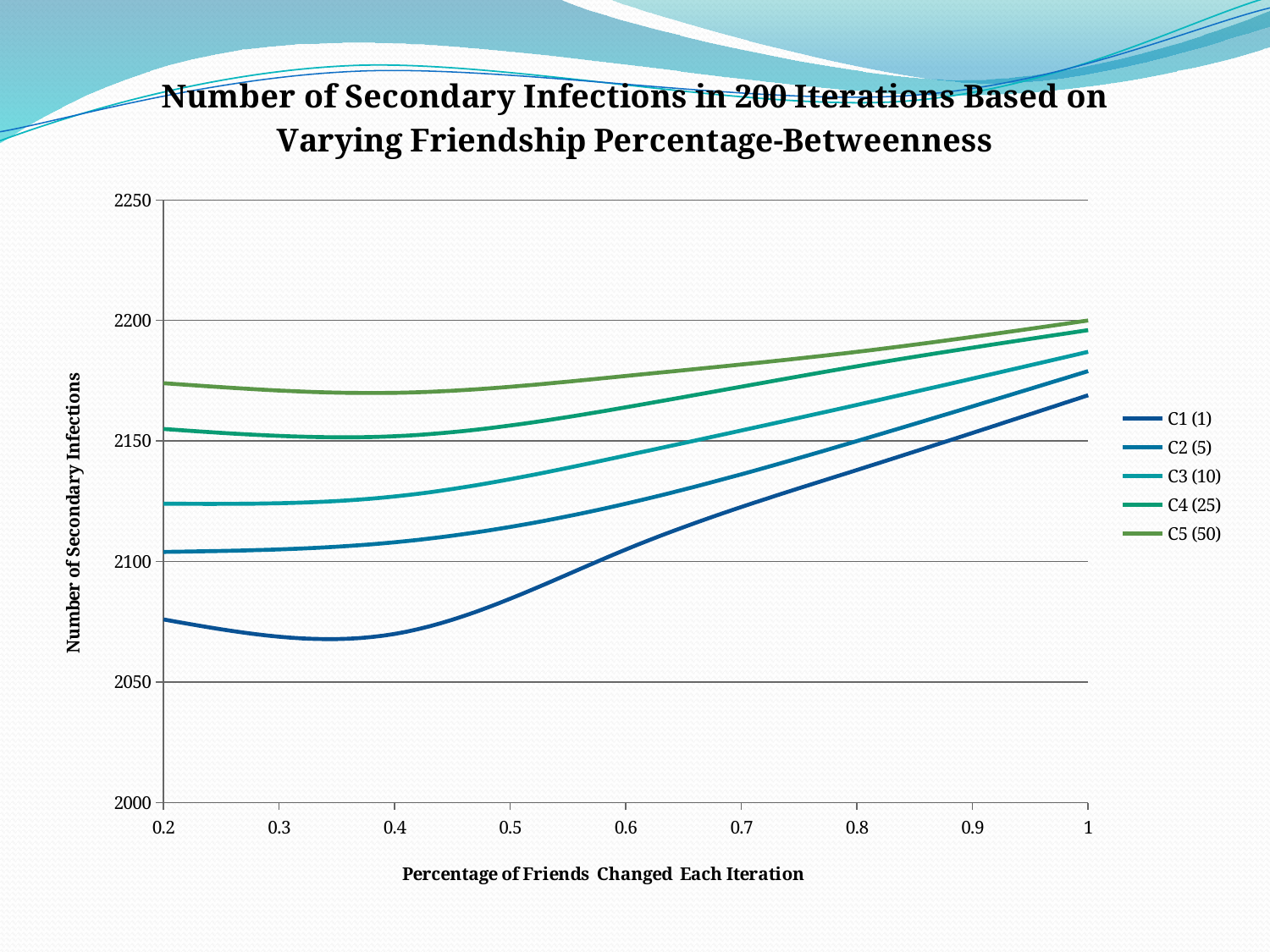
What kind of chart is shown on the slide? line chart Which series has the highest value at x = 1? C5 (50) Is the value for C2 (5) at x = 1 greater or less than 2150? greater Which series has the lowest value at x = 0.2? C1 (1) What is the title of the chart? Number of Secondary Infections in 200 Iterations Based on Varying Friendship Percentage-Betweenness Is the value for C1 (1) at x = 0.4 greater or less than 2050? greater How many series does the legend list? 5 At x = 0.2, which is larger: the value for C5 (50) or the value for C1 (1)? C5 (50) Is the value for C1 (1) at x = 0.2 greater or less than 2100? less Do the values for C1 (1) rise or fall between x = 0.4 and x = 1? rise What is the label of the x axis? Percentage of Friends Changed Each Iteration